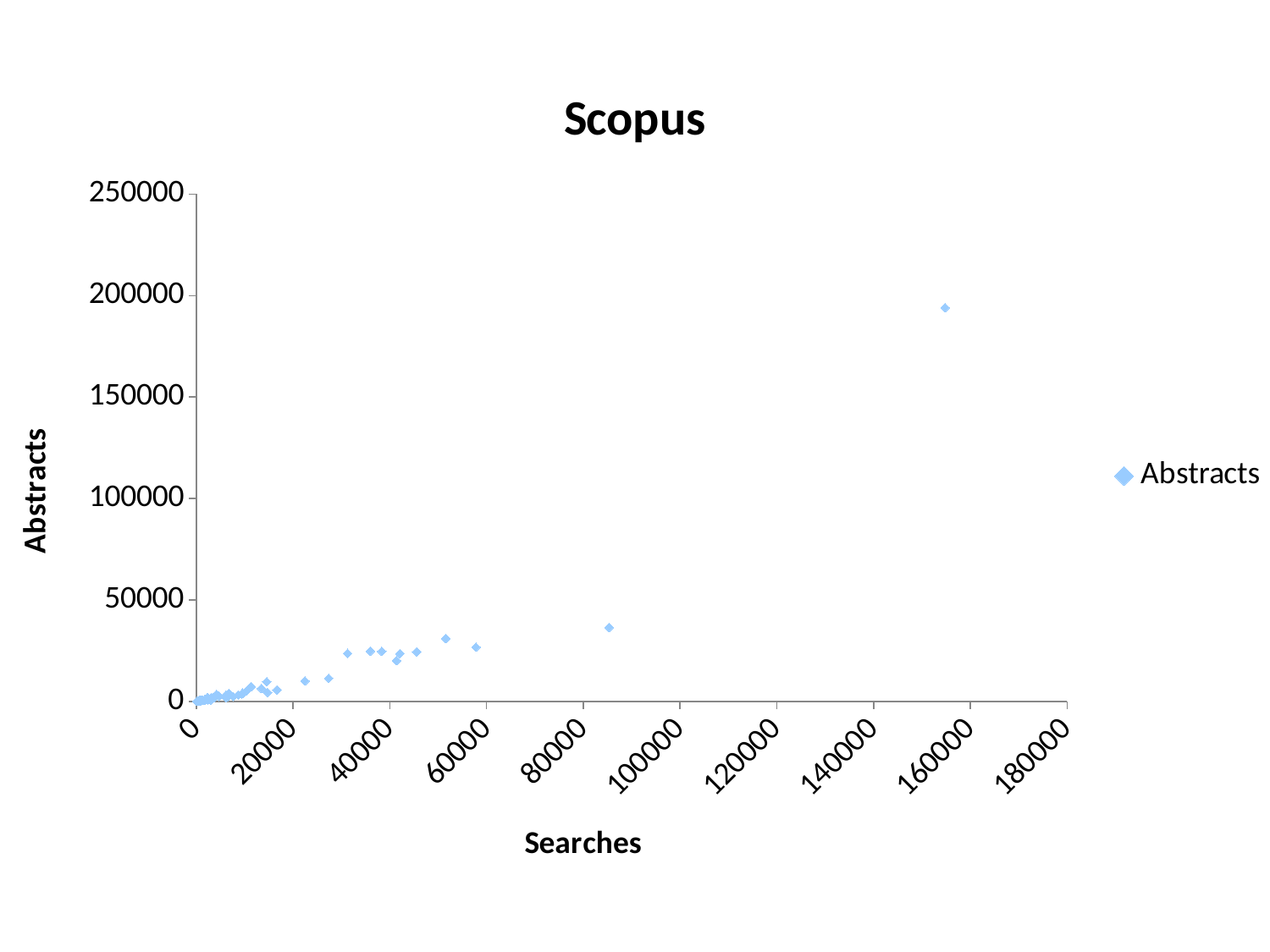
What is the label of the x axis? Searches Is the point with the most searches plotted above or below 140000 on the Searches axis? above How many series does the legend list? 1 What kind of chart is shown on the slide? scatter chart Is the Abstracts value of the point at roughly 86000 searches greater or less than 50000? less Do the Abstracts values generally rise or fall as Searches increase? rise What is the title of the chart? Scopus Are most of the points plotted below or above 40000 on the Abstracts axis? below